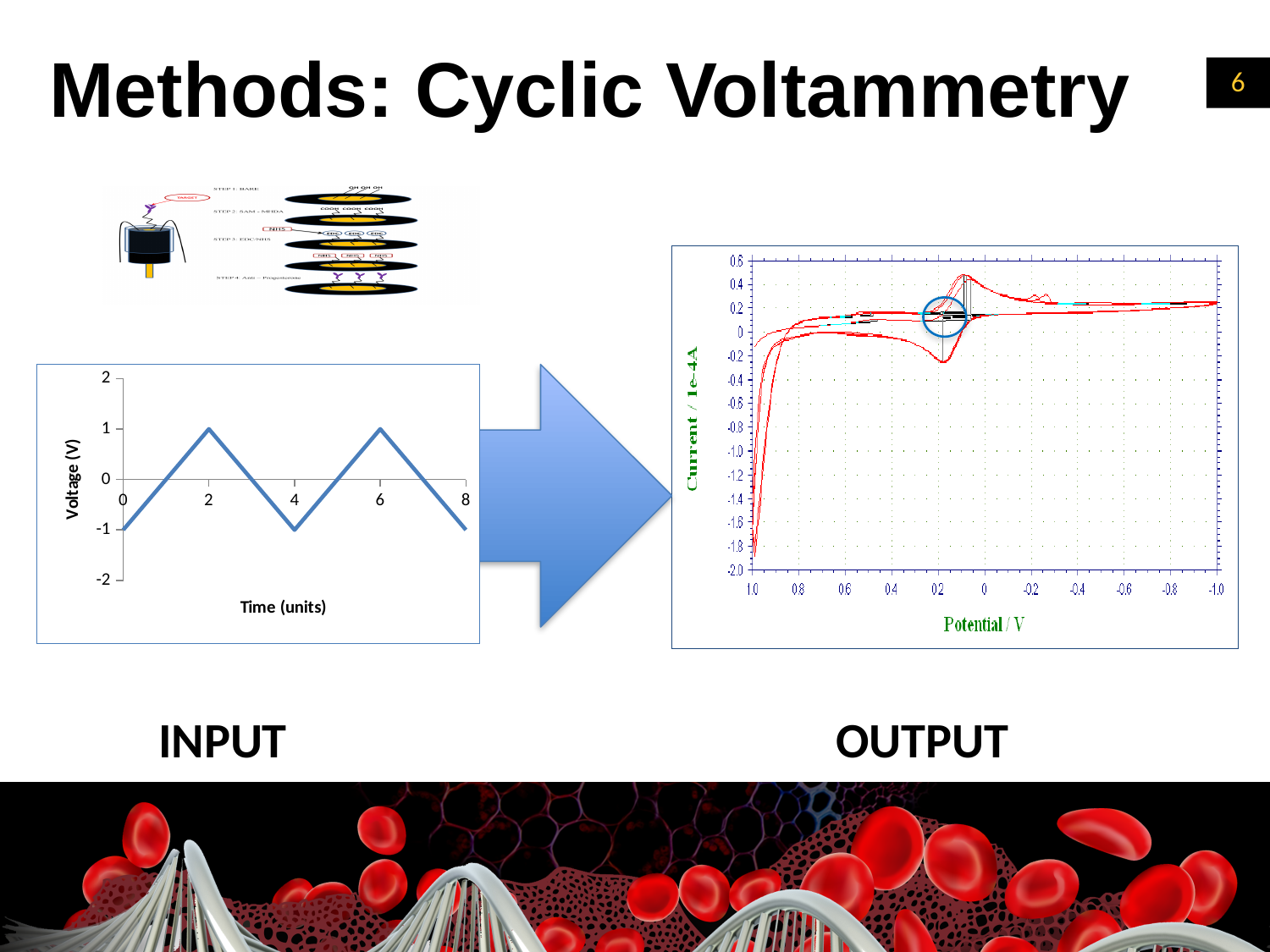
On the INPUT chart, what is the voltage at time 0? -1 On the INPUT chart, does the voltage rise or fall between time 2 and time 4? fall On the INPUT chart, what is the voltage at time 4? -1 On the INPUT chart, what is the label of the y axis? Voltage (V) On the OUTPUT chart, what is the label of the x axis? Potential / V On the OUTPUT chart, is the lowest current value reached near a potential of 1.0 V greater or less than -1.6? less On the INPUT chart, what is the lowest voltage reached by the line? -1 On the INPUT chart, what is the voltage at time 2? 1 What kind of chart is the INPUT chart on the left? line chart On the INPUT chart, is the voltage at time 6 larger or smaller than the voltage at time 8? larger On the INPUT chart, what is the highest voltage reached by the line? 1 On the INPUT chart, what is the label of the x axis? Time (units)